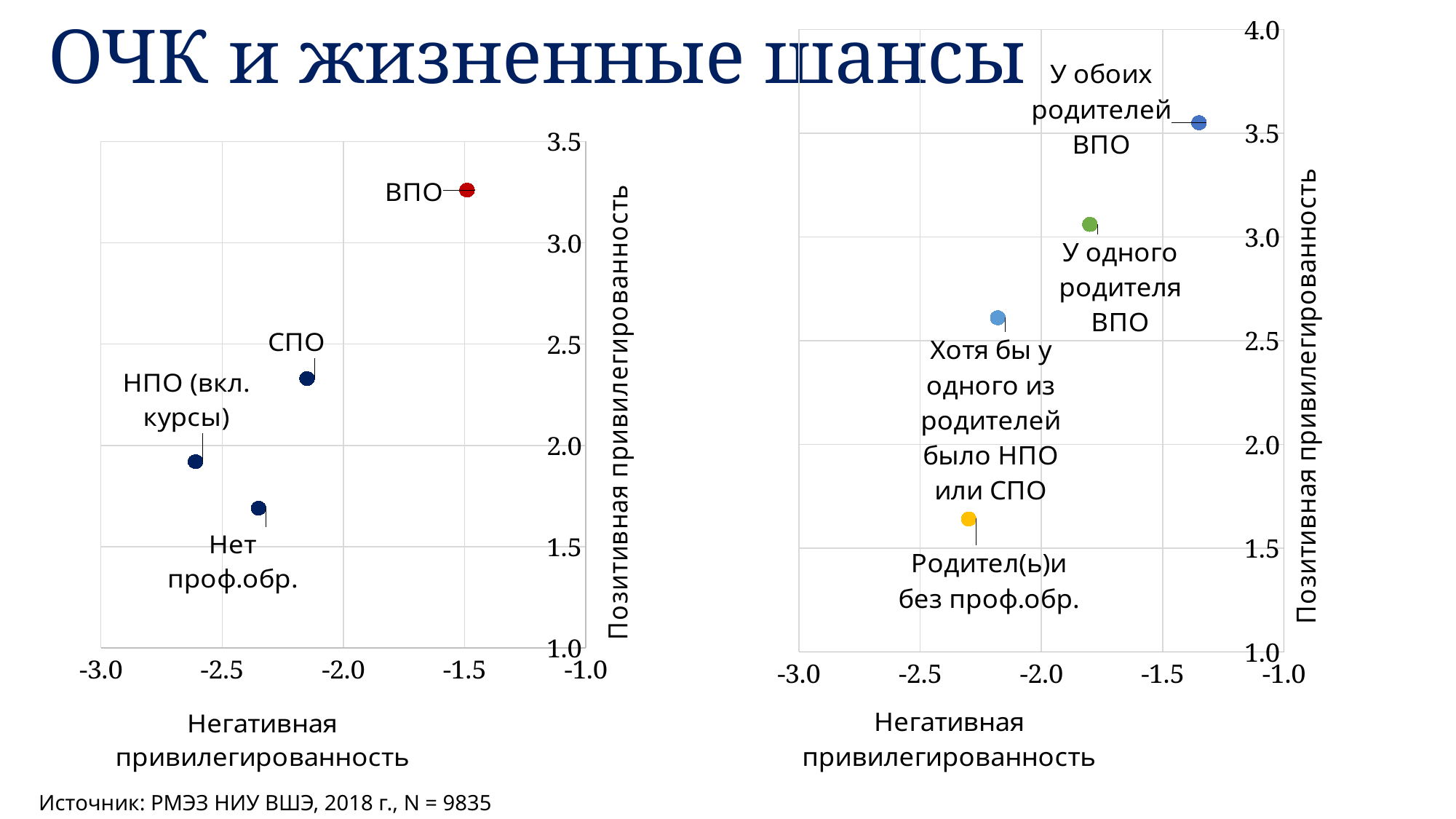
In the left chart, how many data points are plotted? 4 In the left chart, is the Позитивная привилегированность value for СПО greater or less than 2.5? less In the left chart, which category has the lowest value of Позитивная привилегированность? Нет проф.обр. In the right chart, is the Позитивная привилегированность value for У одного родителя ВПО greater or less than 3.0? greater What kind of chart is the left chart on the slide? Scatter chart In the right chart, which category has the highest value of Позитивная привилегированность? У обоих родителей ВПО In the right chart, how many data points are plotted? 4 In the left chart, which category has the highest value of Позитивная привилегированность? ВПО What is the label of the horizontal axis of the left chart? Негативная привилегированность In the right chart, which category has the lowest value of Позитивная привилегированность? Родител(ь)и без проф.обр. In the left chart, which has a higher Позитивная привилегированность value, СПО or НПО (вкл. курсы)? СПО In the left chart, is the Позитивная привилегированность value for ВПО greater or less than 3.0? greater